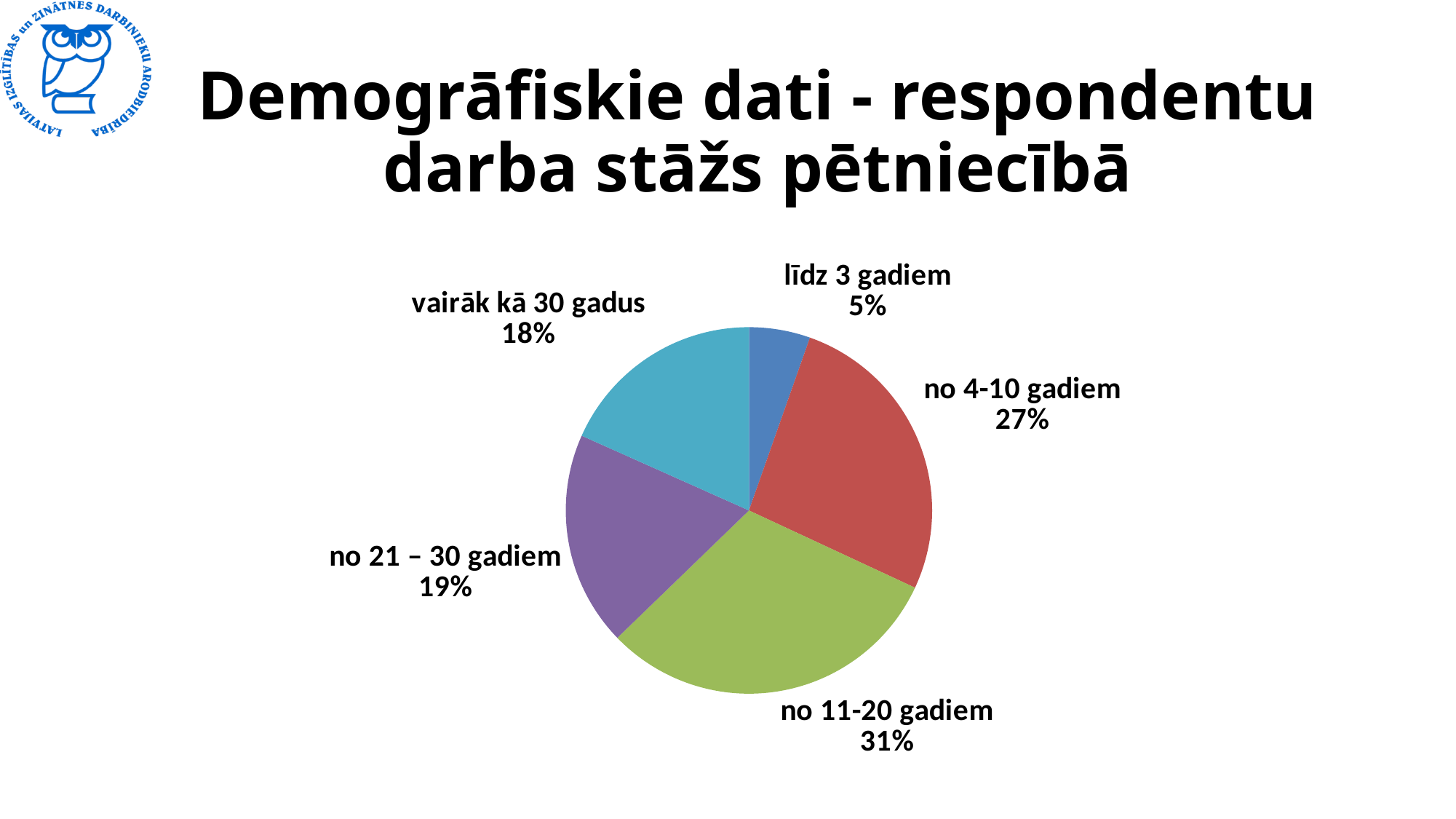
Which category has the smallest share of the pie? līdz 3 gadiem What colour is the 'no 11-20 gadiem' slice? green Which category has the largest share of the pie? no 11-20 gadiem What is the combined share of 'no 21 – 30 gadiem' and 'vairāk kā 30 gadus'? 37% How many categories does the pie chart show? 5 What share of respondents have a research work experience of 'no 11-20 gadiem'? 31% Which is larger: the share for 'no 21 – 30 gadiem' or for 'vairāk kā 30 gadus'? no 21 – 30 gadiem What kind of chart is shown on the slide? pie chart What is the difference in percentage points between 'no 11-20 gadiem' and 'no 4-10 gadiem'? 4 What percentage is shown for the 'no 4-10 gadiem' slice? 27% What percentage is shown for the 'līdz 3 gadiem' slice? 5% What percentage is shown for the 'vairāk kā 30 gadus' slice? 18%